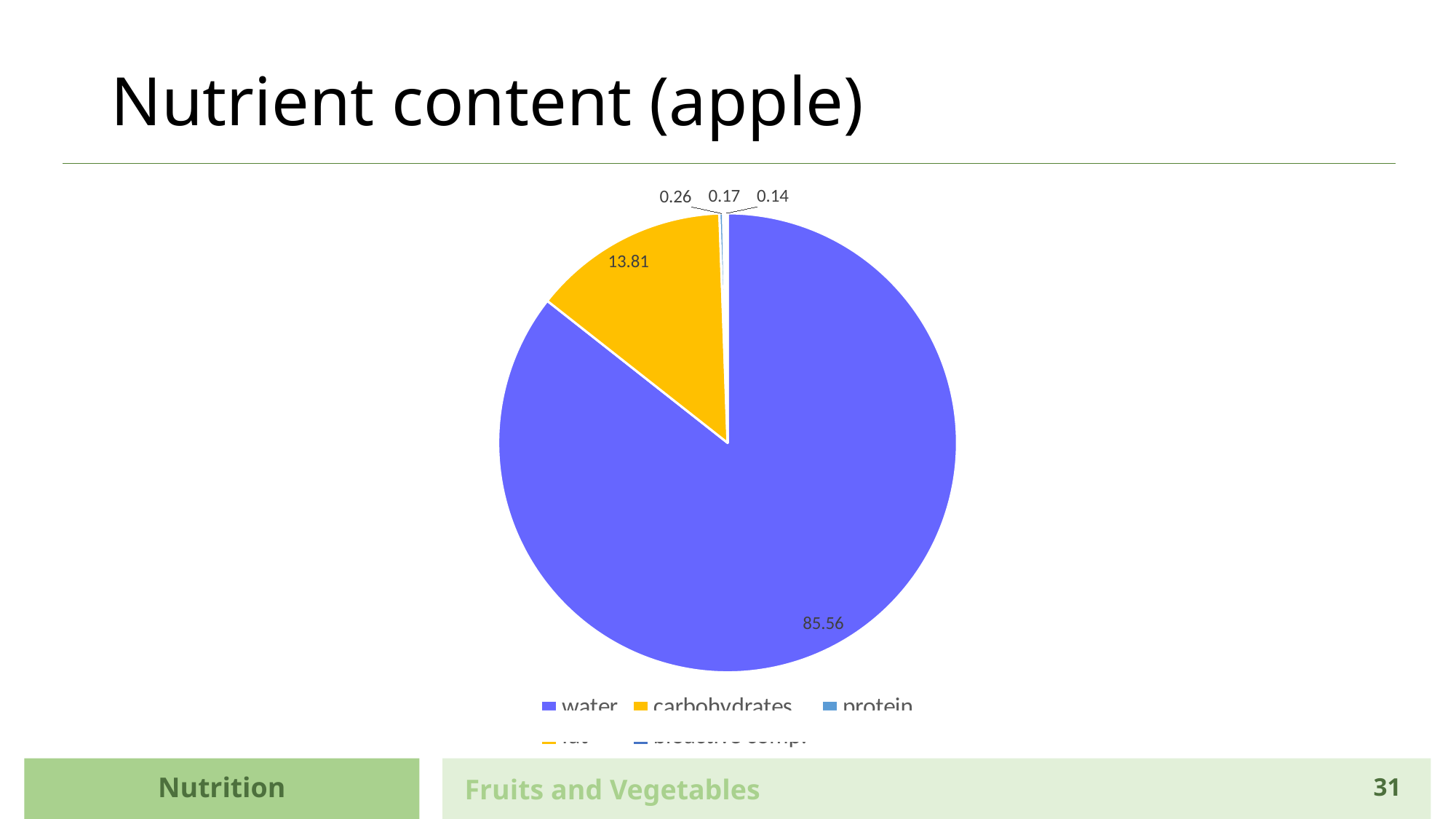
What is the title of the slide containing the pie chart? Nutrient content (apple) What is the smallest value labelled on the pie chart? 0.14 What is the value shown for protein in the pie chart? 0.26 How many slices does the pie chart have? 5 What is the difference between the value for water and the value for carbohydrates? 71.75 What is the value shown for carbohydrates in the pie chart? 13.81 Which is larger, the value for water or the value for carbohydrates? water What kind of chart is shown on the slide? pie chart How many entries does the legend list? 5 What is the value shown for water in the pie chart? 85.56 What colour is the water slice in the pie chart? blue Which category has the largest slice of the pie? water